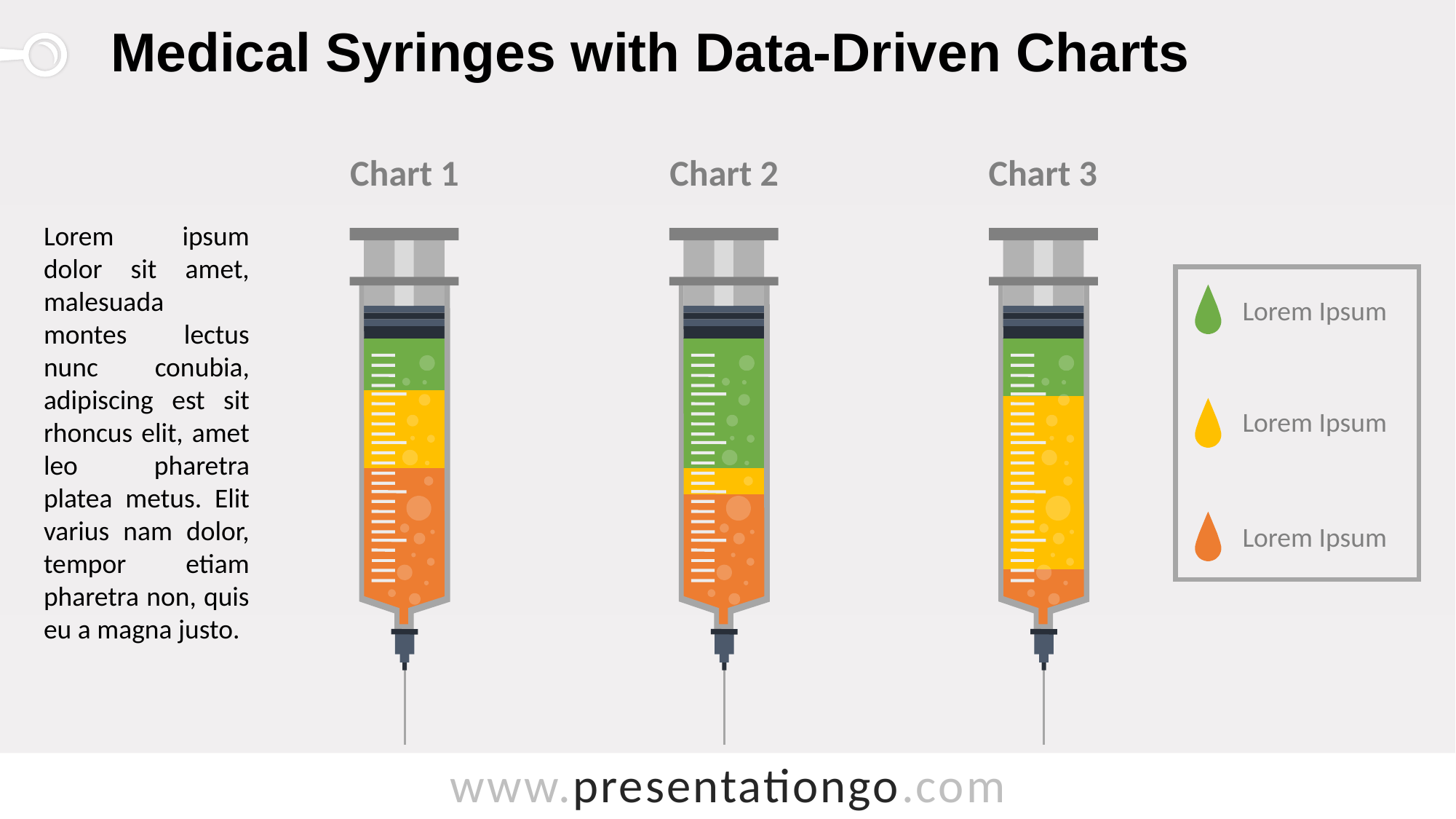
In Chart 1, which colour segment is the smallest? Green How many entries does the legend on the right list? 3 In Chart 3, which is larger, the green segment or the yellow segment? Yellow In Chart 1, which is larger, the yellow segment or the orange segment? Orange What is the title of the middle chart? Chart 2 In Chart 1, which colour segment is the largest? Orange What kind of chart is Chart 1? Stacked bar chart In Chart 2, which colour segment is the smallest? Yellow In Chart 3, which colour segment is the smallest? Orange What three colours are used for the segments in the charts? Green, yellow and orange In Chart 3, which colour segment is the largest? Yellow How many charts are shown on the slide? 3